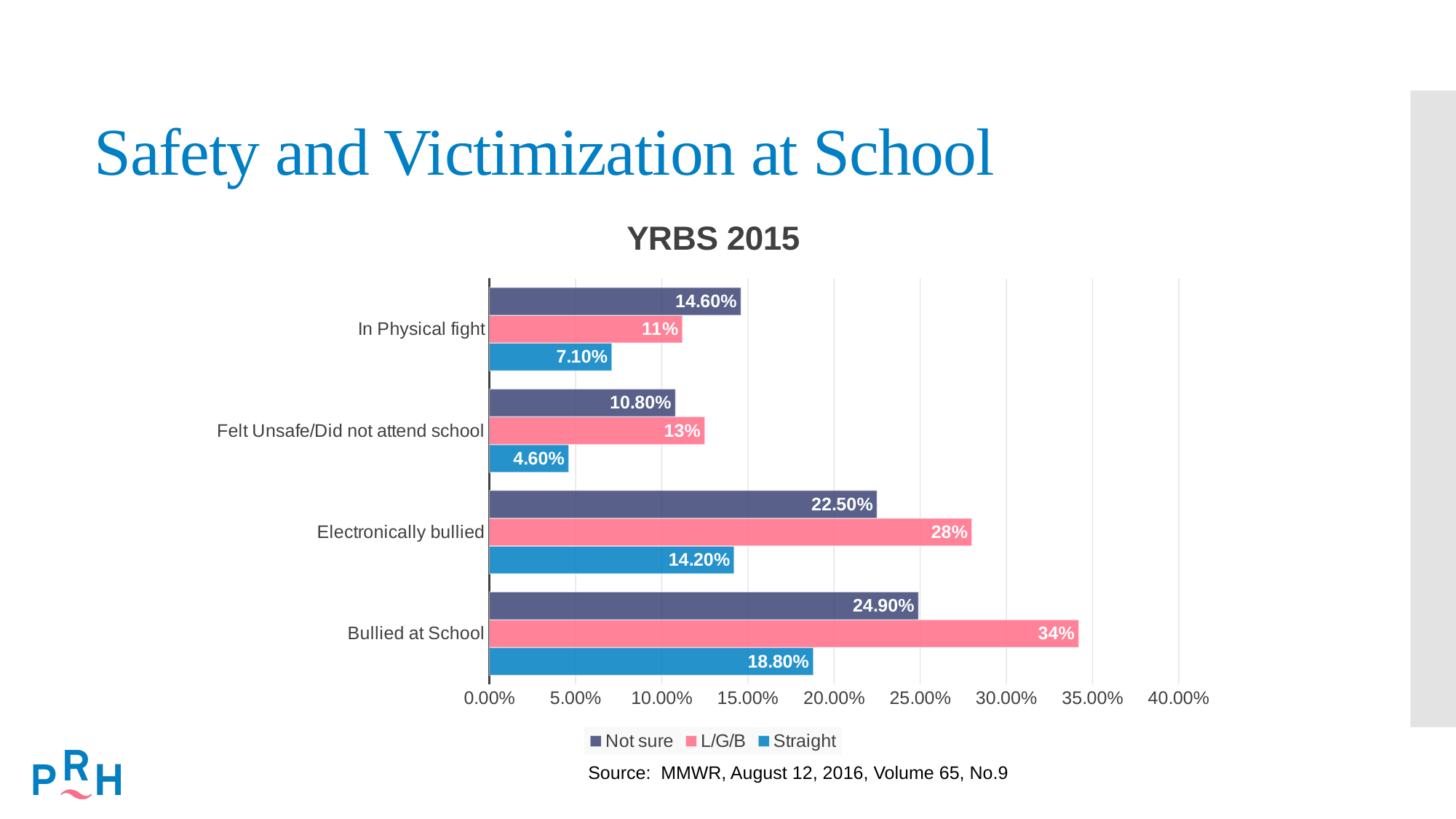
How many series does the legend list? 3 Which is larger in the In Physical fight category: the Not sure value or the L/G/B value? Not sure What is the difference between the L/G/B and Straight values for Bullied at School? 15.20% What is the value for L/G/B in the Bullied at School category? 34% What is the value for Not sure in the Electronically bullied category? 22.50% Which category has the lowest value for the L/G/B series? In Physical fight What is the title of the chart? YRBS 2015 Which category has the highest value for the Straight series? Bullied at School Is the value for L/G/B in the Electronically bullied category greater or less than 25.00%? greater What is the value for Straight in the Felt Unsafe/Did not attend school category? 4.60% What kind of chart is shown on the slide? Bar chart How many categories are shown on the chart? 4